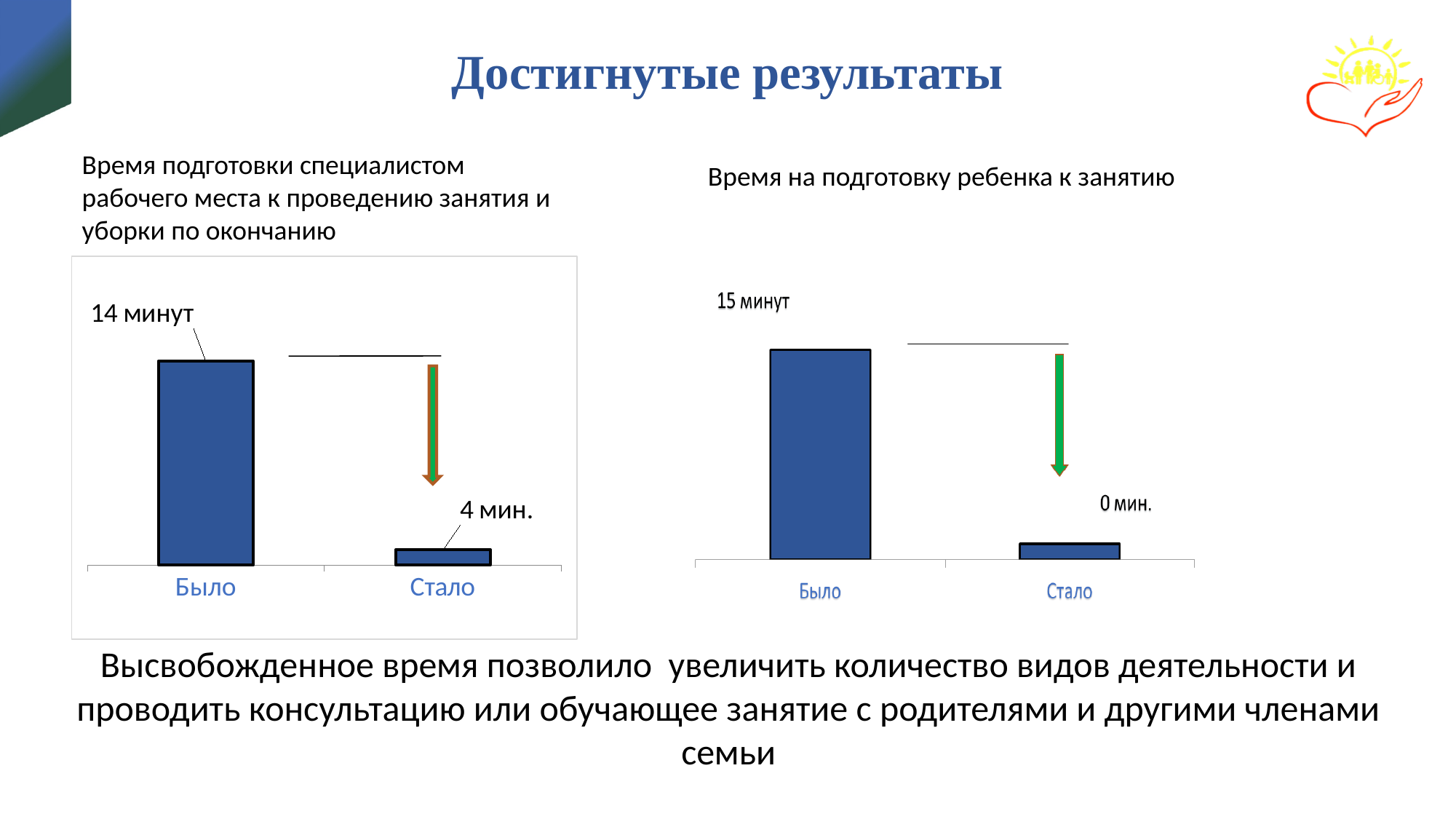
На левой диаграмме («Время подготовки специалистом рабочего места...») какая категория имеет наибольшее значение? Было На правой диаграмме («Время на подготовку ребенка к занятию») значения растут или падают от «Было» к «Стало»? Падают На правой диаграмме («Время на подготовку ребенка к занятию») на сколько минут значение «Было» больше значения «Стало»? 15 На правой диаграмме («Время на подготовку ребенка к занятию») какое значение указано для категории «Стало»? 0 мин. На правой диаграмме («Время на подготовку ребенка к занятию») какое значение указано для категории «Было»? 15 минут Сколько категорий показано на правой диаграмме («Время на подготовку ребенка к занятию»)? 2 На левой диаграмме («Время подготовки специалистом рабочего места...») какое значение больше: «Было» или «Стало»? Было На левой диаграмме («Время подготовки специалистом рабочего места...») какое значение указано для категории «Было»? 14 минут Какого типа левая диаграмма («Время подготовки специалистом рабочего места...»)? Столбчатая (bar chart) На правой диаграмме («Время на подготовку ребенка к занятию») какая категория имеет наименьшее значение? Стало На левой диаграмме («Время подготовки специалистом рабочего места...») на сколько минут значение «Было» больше значения «Стало»? 10 На левой диаграмме («Время подготовки специалистом рабочего места...») какое значение указано для категории «Стало»? 4 мин.